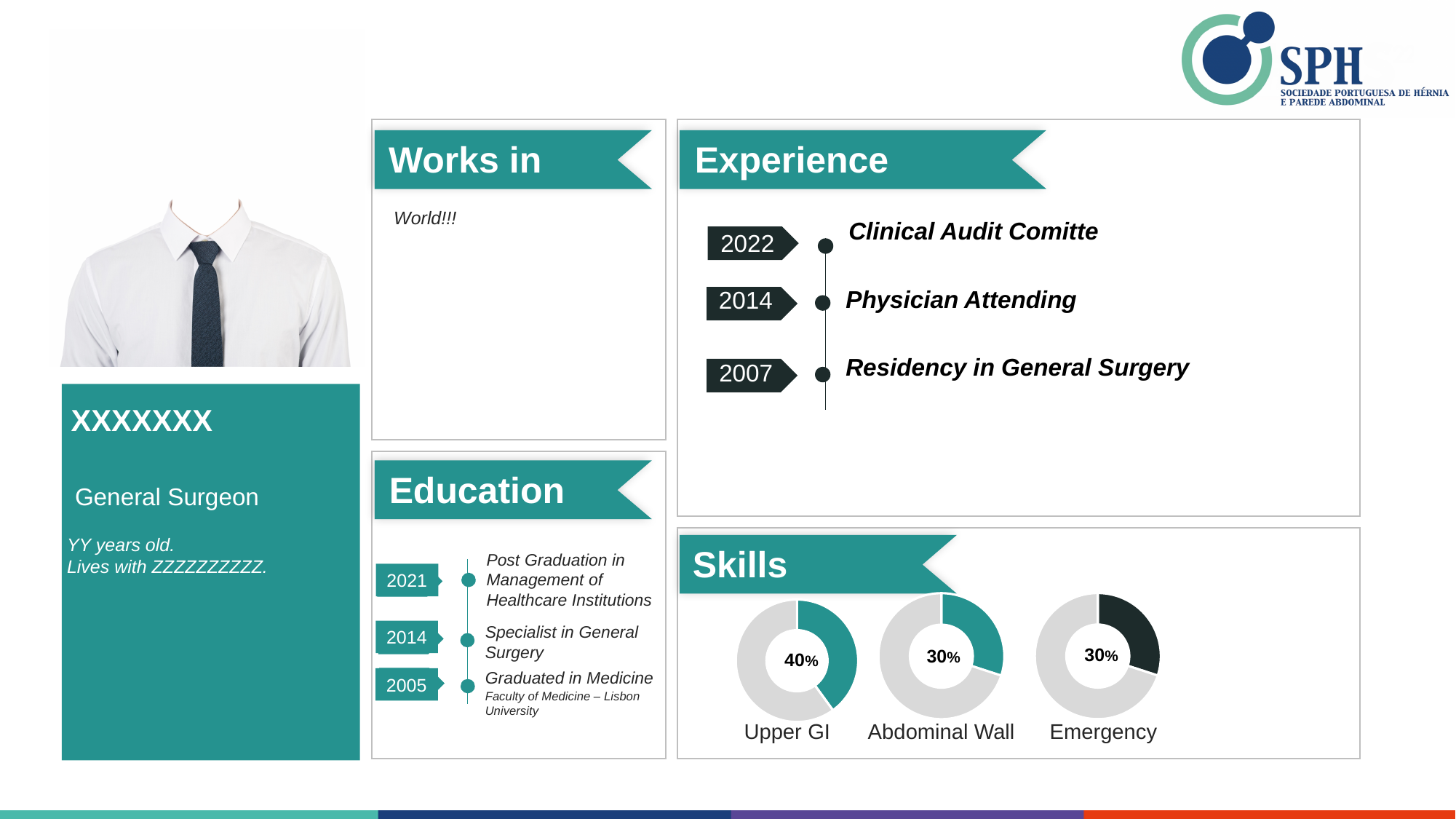
In the Skills section, what colour is the filled portion of the Upper GI donut chart? Teal In the Skills section, what value is shown in the Abdominal Wall donut chart? 30% In the Skills section, what value is shown in the Upper GI donut chart? 40% In the Skills section, what is the difference between the Upper GI value and the Emergency value? 10% Among the three Skills donut charts, which skill has the highest value? Upper GI In the Skills section, which is larger: the Upper GI value or the Abdominal Wall value? Upper GI In the Skills section, what value is shown in the Emergency donut chart? 30% In the Skills section, is the Upper GI value greater or less than 50%? less In the Skills section, do the Abdominal Wall and Emergency charts show the same value? Yes How many donut charts are shown in the Skills section? 3 What kind of chart is used to show each skill in the Skills section? Donut chart In the Skills section, what colour is the filled portion of the Emergency donut chart? Dark (black)